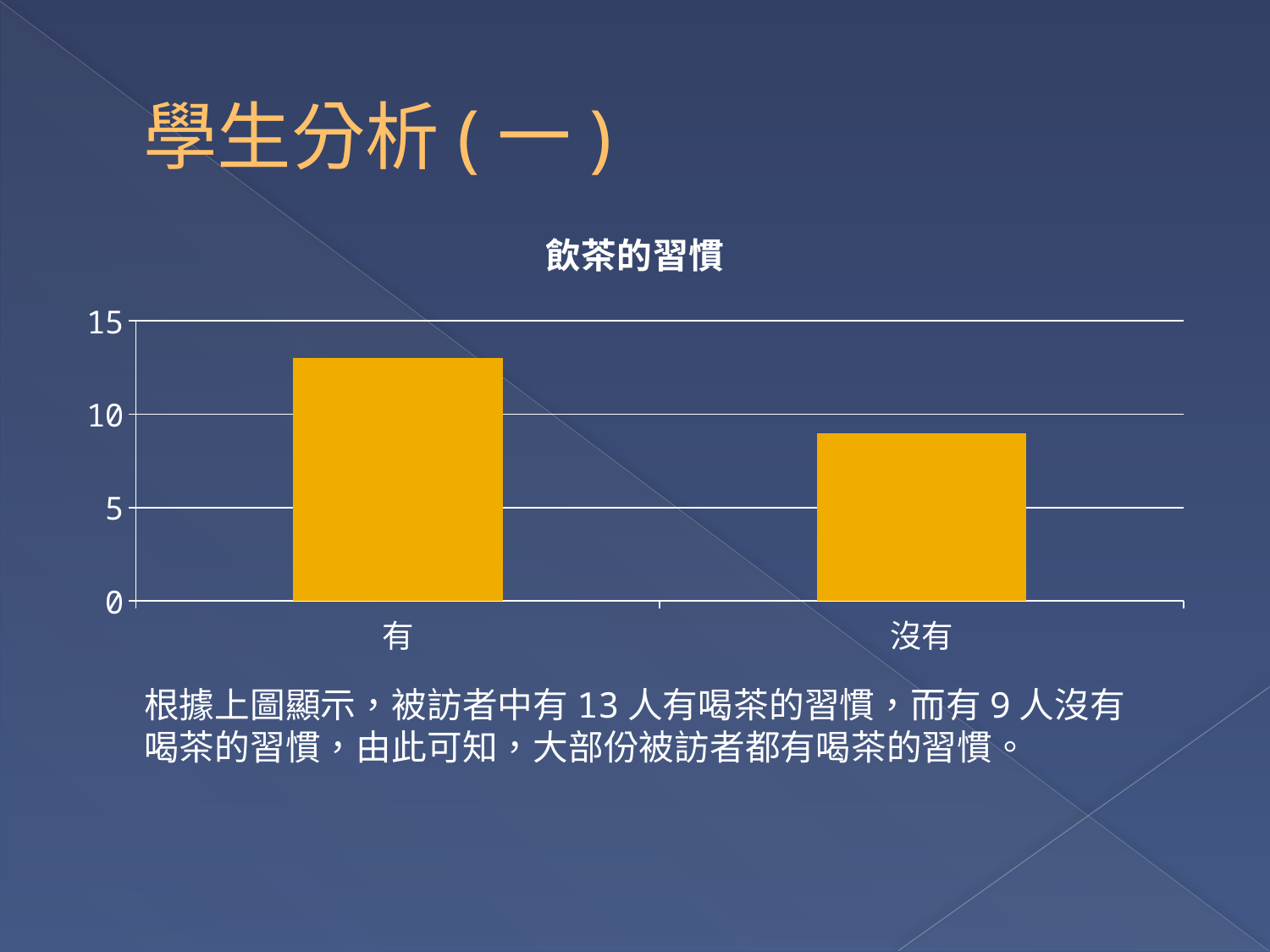
What is the title of the chart? 飲茶的習慣 Which is larger, the value for 有 or the value for 沒有? 有 Is the value for 沒有 greater or less than 5? greater How many categories are shown on the x axis of the chart? 2 What is the difference between the number of respondents for 有 and 沒有? 4 Which category has the lowest bar in the chart? 沒有 Which category has the highest bar in the chart? 有 Is the value for 有 greater or less than 10? greater Is the value for 沒有 greater or less than 10? less According to the slide, how many respondents do not have the habit of drinking tea (沒有)? 9 According to the slide, how many respondents have the habit of drinking tea (有)? 13 What kind of chart is shown on the slide? bar chart